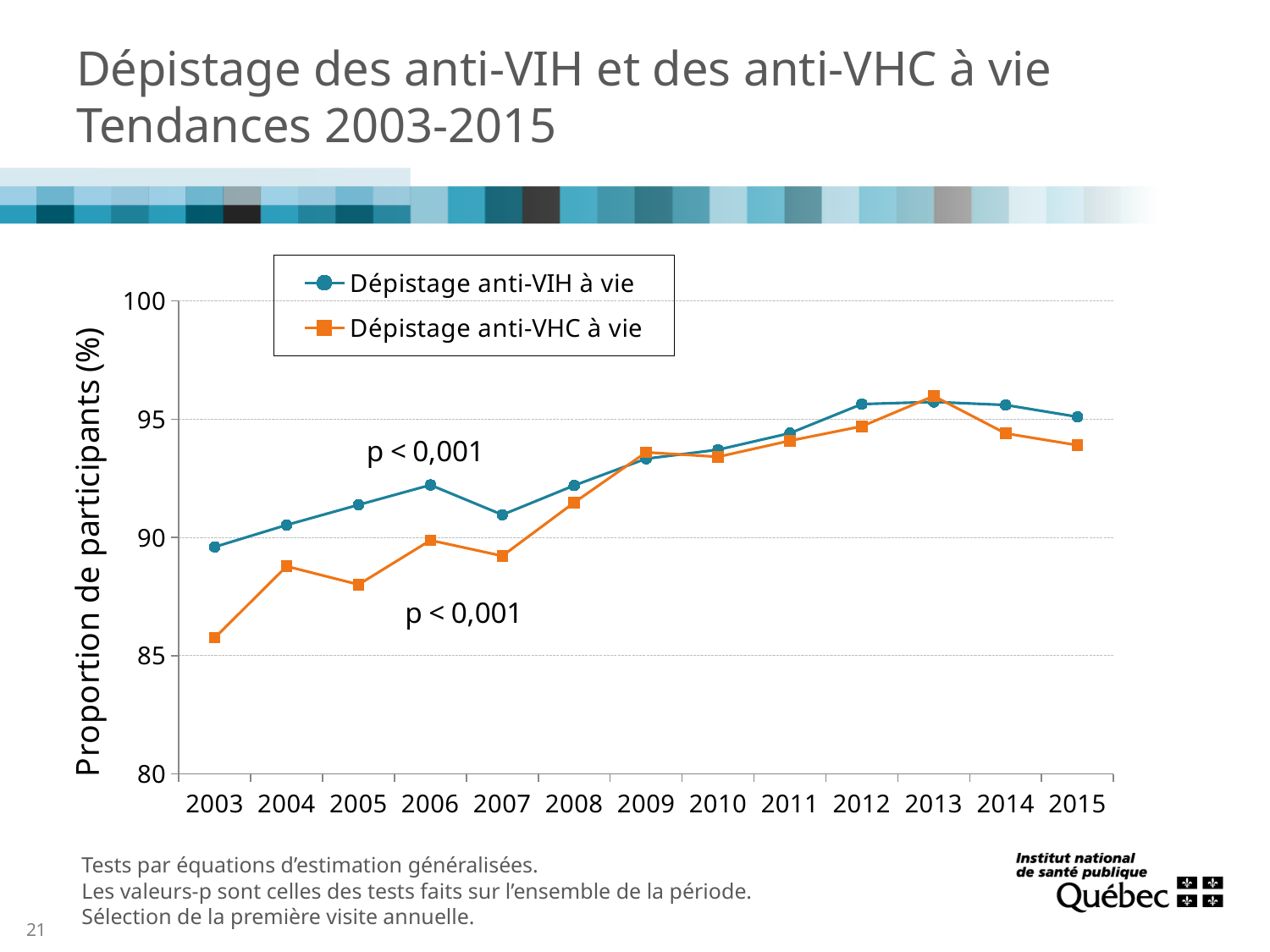
Is the value for Dépistage anti-VIH à vie in 2012 greater or less than 95? greater Overall, do the values for Dépistage anti-VHC à vie rise or fall from 2003 to 2015? rise Is the value for Dépistage anti-VHC à vie in 2005 greater or less than 90? less How many years are plotted along the x axis? 13 What kind of chart is shown on the slide? line chart How many series does the legend list? 2 In 2003, which series has the larger value, Dépistage anti-VIH à vie or Dépistage anti-VHC à vie? Dépistage anti-VIH à vie What is the label of the y axis? Proportion de participants (%) Which year has the highest value for Dépistage anti-VHC à vie? 2013 Is the value for Dépistage anti-VHC à vie in 2010 greater or less than 95? less Which year has the lowest value for Dépistage anti-VIH à vie? 2003 Which year has the lowest value for Dépistage anti-VHC à vie? 2003